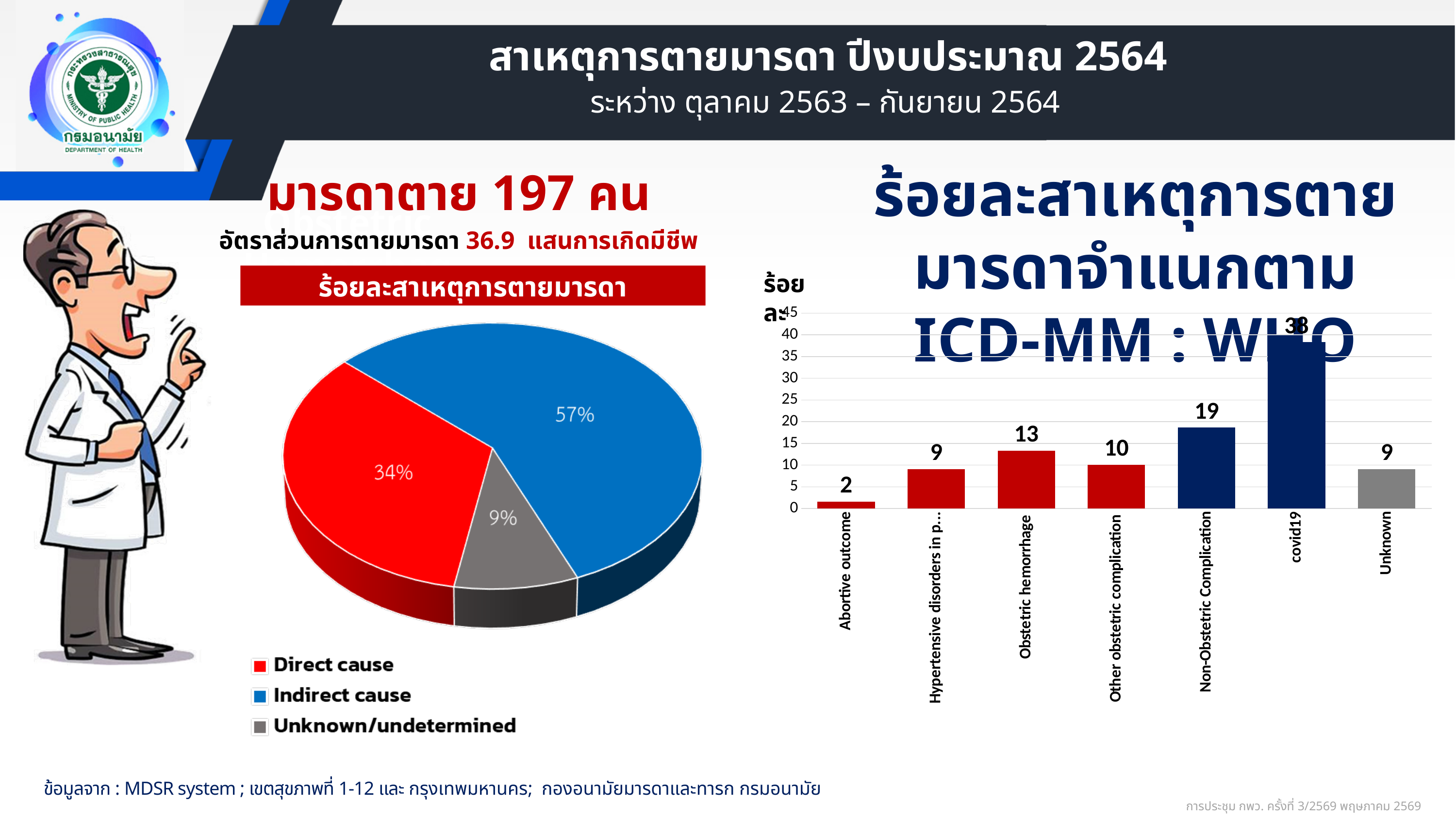
In the pie chart on the left, what percentage is shown for Unknown/undetermined? 9% In the pie chart on the left, which category has the largest slice? Indirect cause How many slices does the pie chart on the left have? 3 In the bar chart on the right, which category has the highest value? covid19 In the bar chart on the right, what is the value for Non-Obstetric Complication? 19 In the pie chart on the left, what percentage is shown for Direct cause? 34% In the bar chart on the right, what is the value for Obstetric hemorrhage? 13 In the bar chart on the right, which category has the lowest value? Abortive outcome How many categories are shown in the bar chart on the right? 7 In the bar chart on the right, what is the difference between the values for Non-Obstetric Complication and Obstetric hemorrhage? 6 In the bar chart on the right, is the value for covid19 greater or less than 35? greater In the pie chart on the left, what percentage is shown for Indirect cause? 57%